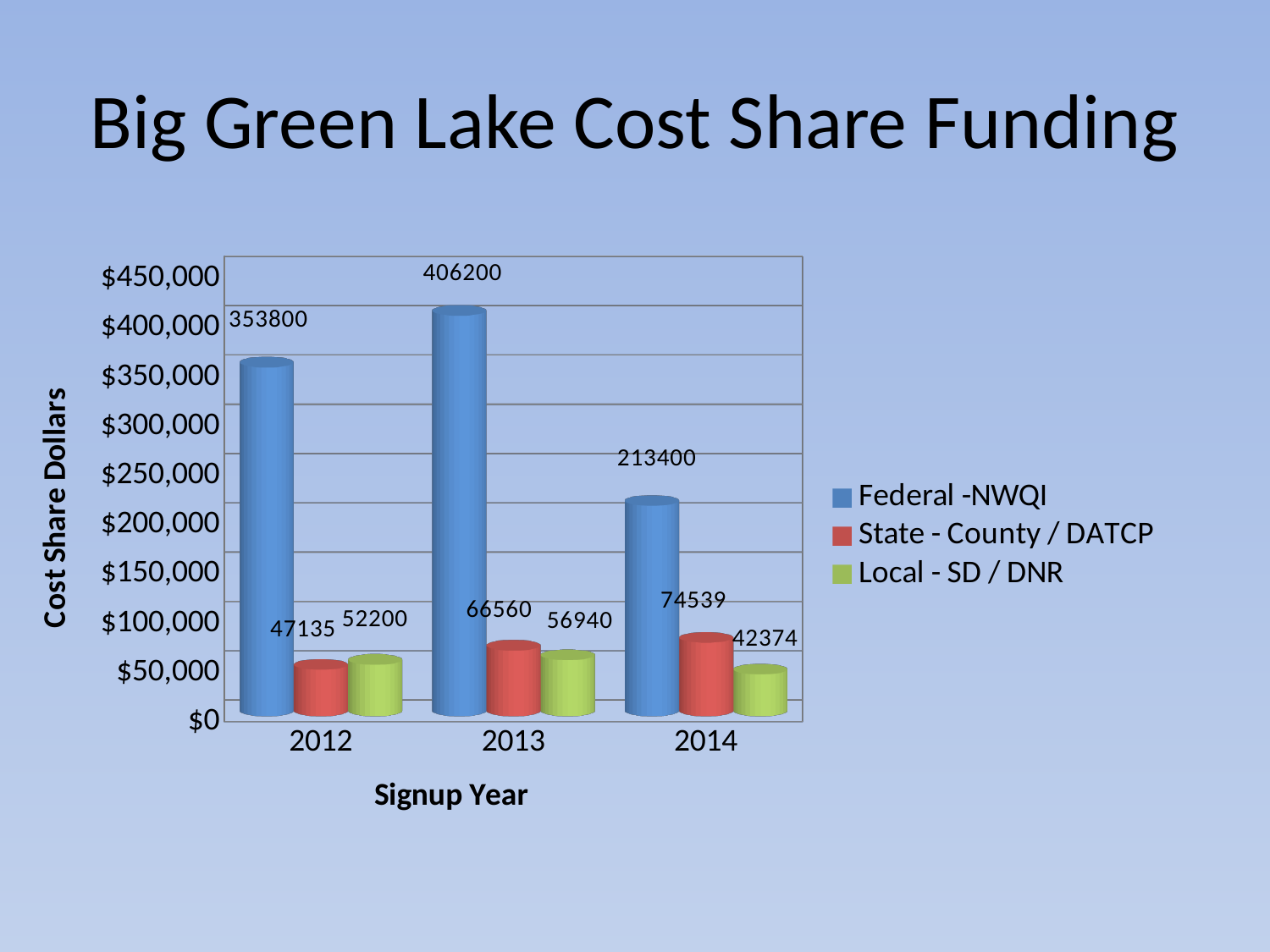
What is the difference between the Federal -NWQI values for 2013 and 2014? 192800 How many series does the legend list? 3 What is the label of the y axis? Cost Share Dollars What is the Federal -NWQI value for 2013? 406200 In which signup year is the Local - SD / DNR value lowest? 2014 Is the Federal -NWQI value for 2014 greater or less than $250,000? less What kind of chart is shown on the slide? bar chart What is the State - County / DATCP value for 2012? 47135 In which signup year is the Federal -NWQI value highest? 2013 How many signup years are shown on the x axis? 3 Which is larger in 2012: the State - County / DATCP value or the Local - SD / DNR value? Local - SD / DNR What is the Local - SD / DNR value for 2014? 42374